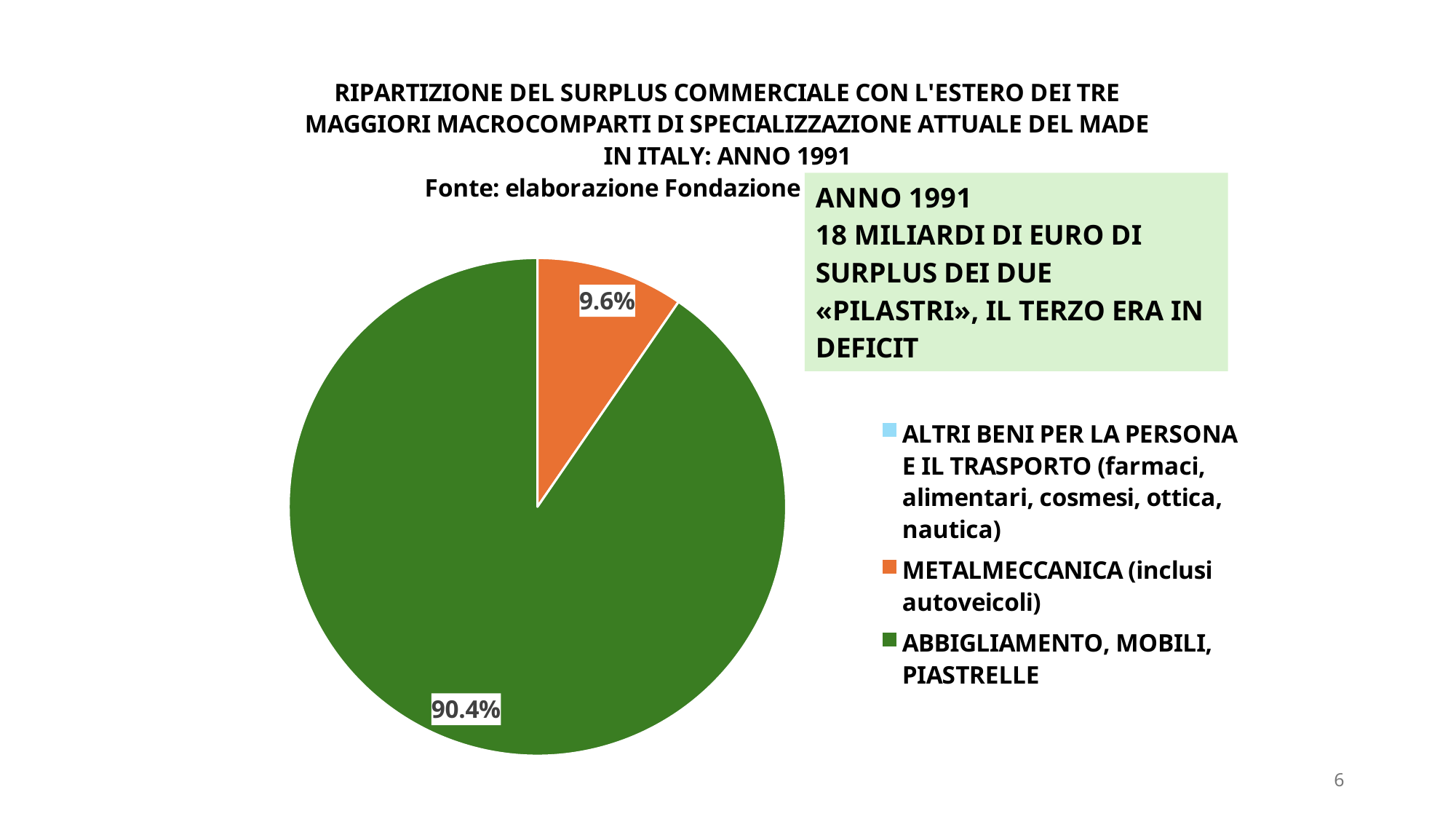
Which category has the largest slice of the pie? ABBIGLIAMENTO, MOBILI, PIASTRELLE What kind of chart is shown on the slide? Pie chart Which is larger: the slice for METALMECCANICA (inclusi autoveicoli) or the slice for ABBIGLIAMENTO, MOBILI, PIASTRELLE? ABBIGLIAMENTO, MOBILI, PIASTRELLE How many entries does the legend of the pie chart list? 3 Which year does the pie chart title refer to? 1991 What share of the pie does METALMECCANICA (inclusi autoveicoli) hold? 9.6% What share of the pie does ABBIGLIAMENTO, MOBILI, PIASTRELLE hold? 90.4% What is the difference in percentage points between the ABBIGLIAMENTO, MOBILI, PIASTRELLE slice and the METALMECCANICA (inclusi autoveicoli) slice? 80.8 percentage points Which of the two labelled slices is the smaller one? METALMECCANICA (inclusi autoveicoli) What colour is the slice for METALMECCANICA (inclusi autoveicoli)? Orange How many slices with a data label are visible in the pie chart? 2